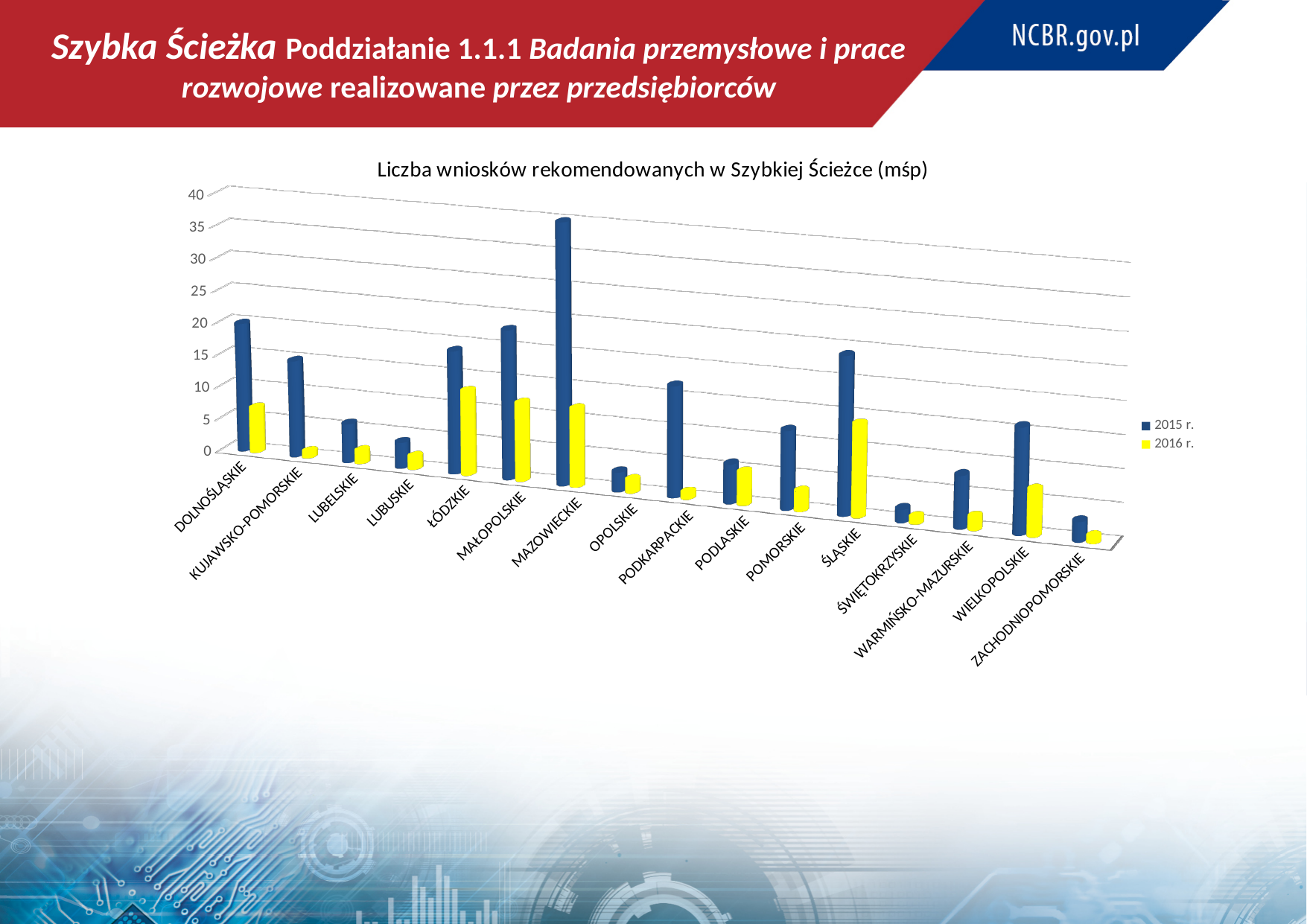
Which is larger for MAZOWIECKIE: the 2015 r. value or the 2016 r. value? 2015 r. Is the 2015 r. value for ŚLĄSKIE greater or less than 10? greater What kind of chart is shown on the slide? bar chart How many series does the legend list? 2 Is the 2015 r. value for DOLNOŚLĄSKIE greater or less than 15? greater Is the 2015 r. value for LUBUSKIE greater or less than 5? less How many voivodeships (categories) are shown on the x axis? 16 Which voivodeship has the highest value for 2015 r.? MAZOWIECKIE What is the title of the chart? Liczba wniosków rekomendowanych w Szybkiej Ścieżce (mśp) Which has the larger 2015 r. value: MAZOWIECKIE or MAŁOPOLSKIE? MAZOWIECKIE